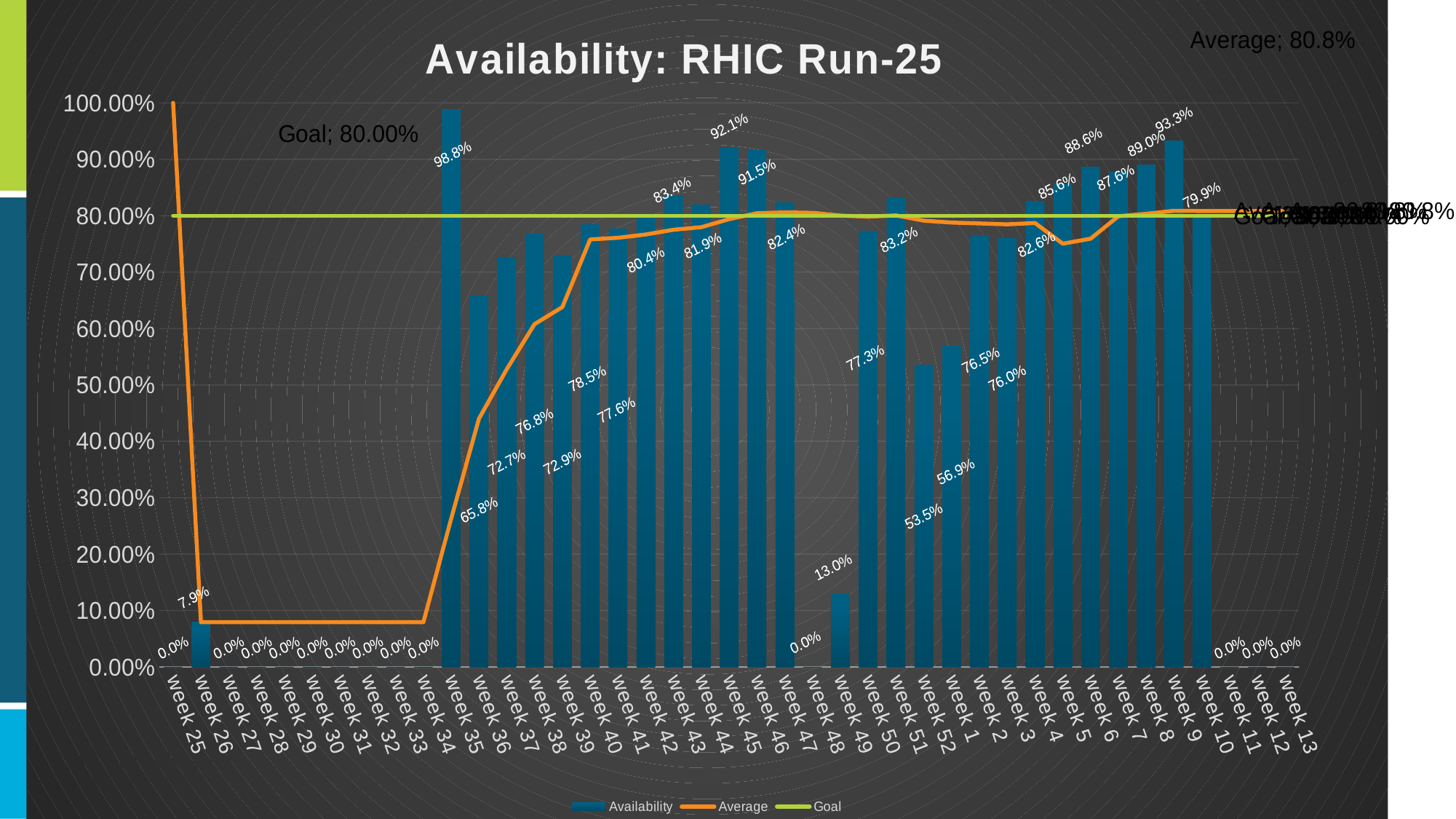
What kind of chart is shown on the slide? Bar chart with line series What is the Goal value shown on the chart? 80.00% How many series does the legend list? 3 What is the availability for week 48? 0.0% Which week has the highest availability? week 35 Is the availability for week 51 greater or less than 60.00%? greater What is the title of the chart? Availability: RHIC Run-25 How many weeks are shown on the x axis? 41 What is the availability for week 34? 0.0% What is the difference between the availability for week 44 and week 45? 10.2% What is the Average value shown on the chart? 80.8% What is the availability for week 26? 7.9%